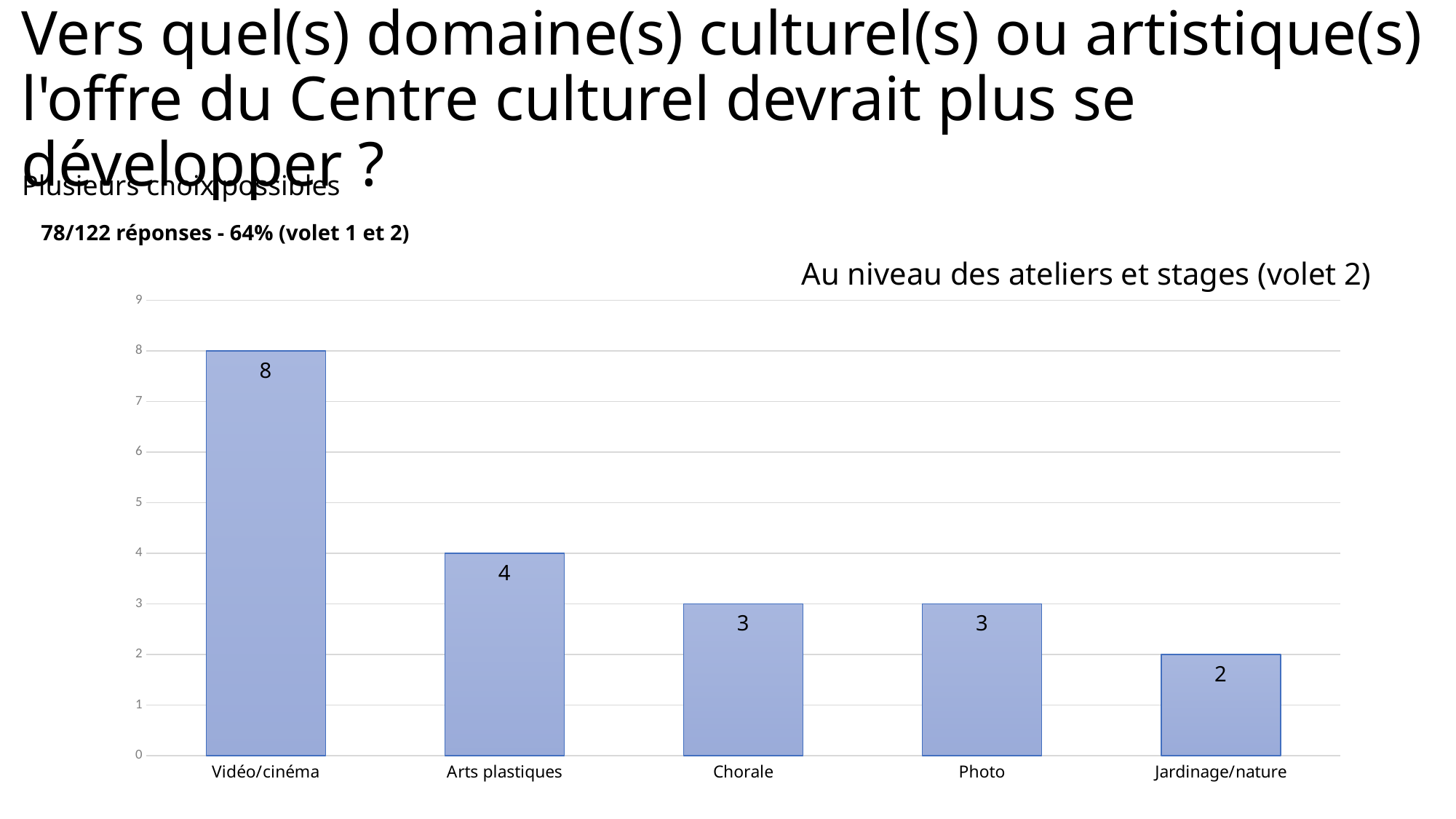
What is the difference between the values for Vidéo/cinéma and Arts plastiques? 4 Which category has the highest value? Vidéo/cinéma Do the values rise or fall from left to right along the x axis? Fall Is the value for Vidéo/cinéma greater or less than 5? greater Which is larger, the value for Arts plastiques or the value for Photo? Arts plastiques What is the value for Jardinage/nature? 2 What kind of chart is shown on the slide? Bar chart What is the value for Arts plastiques? 4 Which category has the lowest value? Jardinage/nature How many categories are shown on the x axis? 5 What is the title of the chart? Au niveau des ateliers et stages (volet 2) What is the value for Vidéo/cinéma? 8